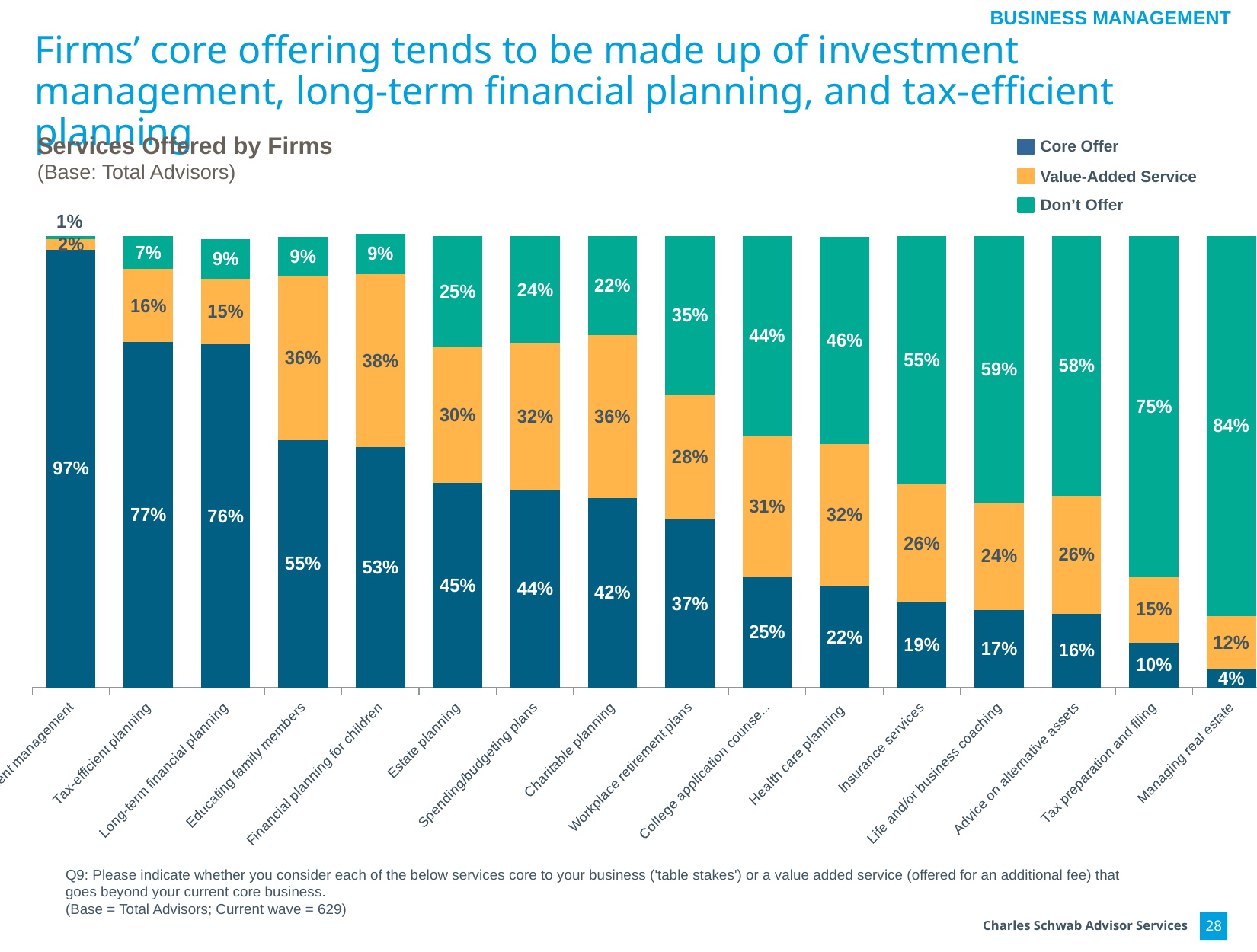
Which category has the highest Don't Offer value? Managing real estate How many service categories are shown on the x axis? 16 Do the Core Offer values rise or fall moving from left to right along the x axis? Fall Which is larger, the Value-Added Service value for Charitable planning or for Workplace retirement plans? Charitable planning What is the difference between the Core Offer values for Estate planning and Health care planning? 23% Which category has the lowest Core Offer value? Managing real estate How many series does the legend list? 3 What is the total of the stacked bar for Tax preparation and filing? 100% What is the Core Offer value for Tax-efficient planning? 77% What kind of chart is shown on the slide? Stacked bar chart What is the Value-Added Service value for Financial planning for children? 38% What is the Don't Offer value for Insurance services? 55%